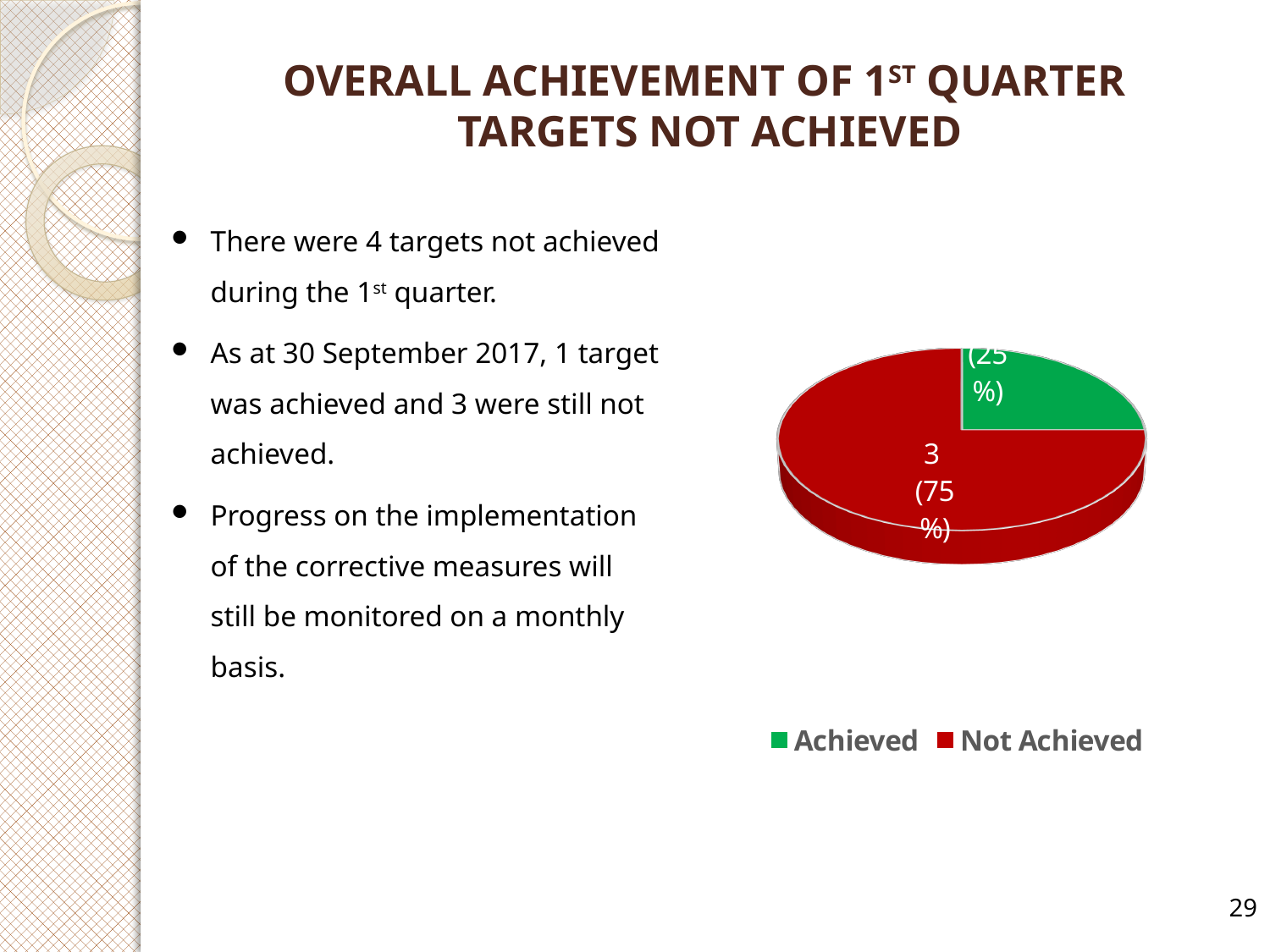
What colour is the Not Achieved slice in the pie chart? Red What percentage of the pie does the Achieved slice represent? 25% By how many percentage points does the Not Achieved share exceed the Achieved share? 50 percentage points What percentage of the pie does the Not Achieved slice represent? 75% What are the two categories listed in the pie chart's legend? Achieved and Not Achieved Which slice of the pie chart is the smallest? Achieved How many targets does the Not Achieved slice of the pie chart represent? 3 How many entries does the legend of the pie chart list? 2 Which slice of the pie chart is the largest? Not Achieved Which is larger in the pie chart, Achieved or Not Achieved? Not Achieved How many slices does the pie chart have? 2 What kind of chart is shown on the slide? Pie chart